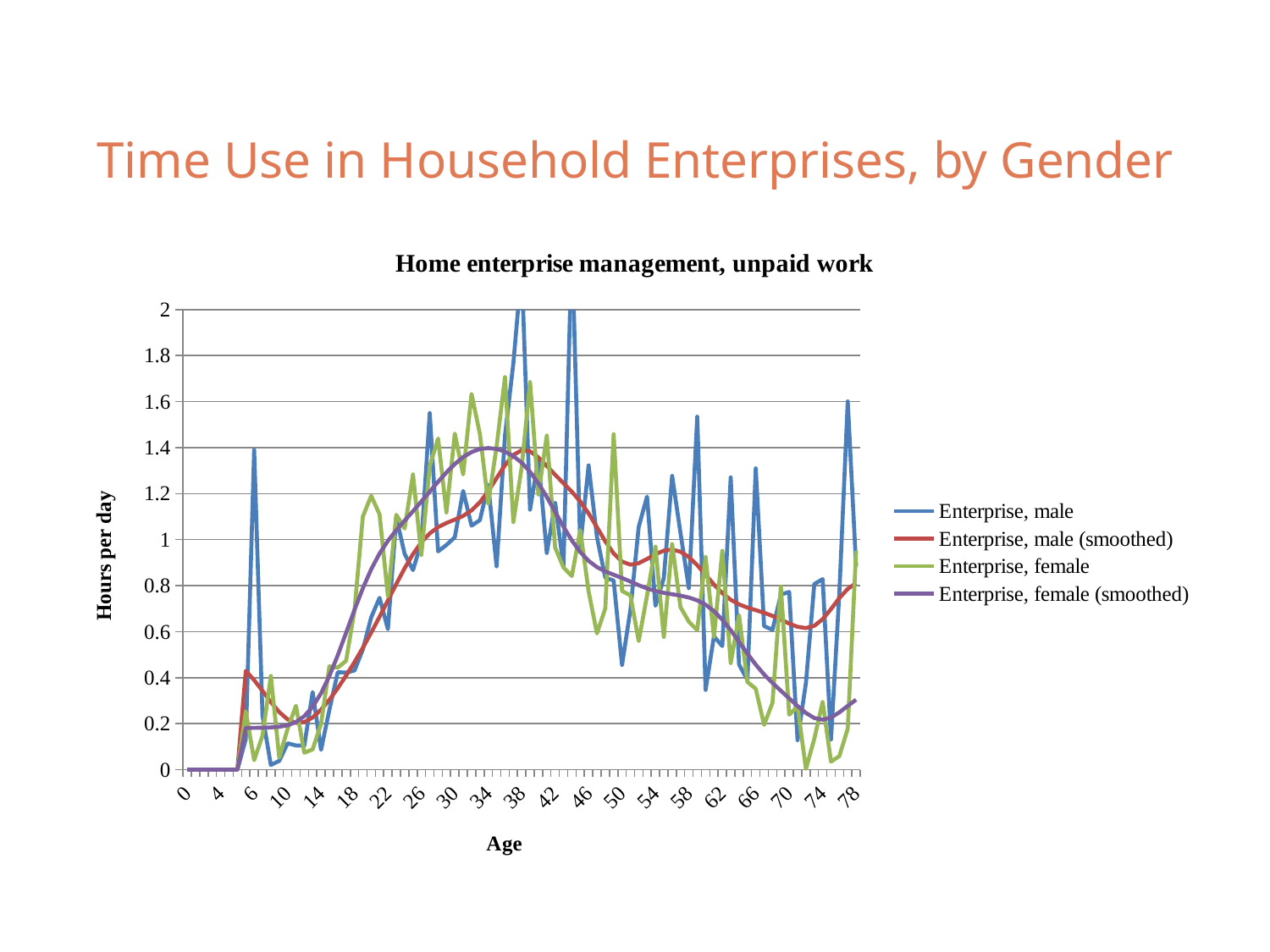
What kind of chart is shown on the slide? line chart Is the value for Enterprise, female (smoothed) at age 74 greater or less than 0.4? less What is the label of the vertical axis? Hours per day What is the title of the chart? Home enterprise management, unpaid work How many series does the legend list? 4 Is the value for Enterprise, female (smoothed) at age 34 greater or less than 1.2? greater Does the Enterprise, female (smoothed) line rise or fall between age 50 and age 74? fall At age 70, which is larger: Enterprise, male (smoothed) or Enterprise, female (smoothed)? Enterprise, male (smoothed) Is the value for Enterprise, male at age 6 greater or less than 1? greater At age 34, which is larger: Enterprise, male (smoothed) or Enterprise, female (smoothed)? Enterprise, female (smoothed) What is the value for Enterprise, male at age 2? 0